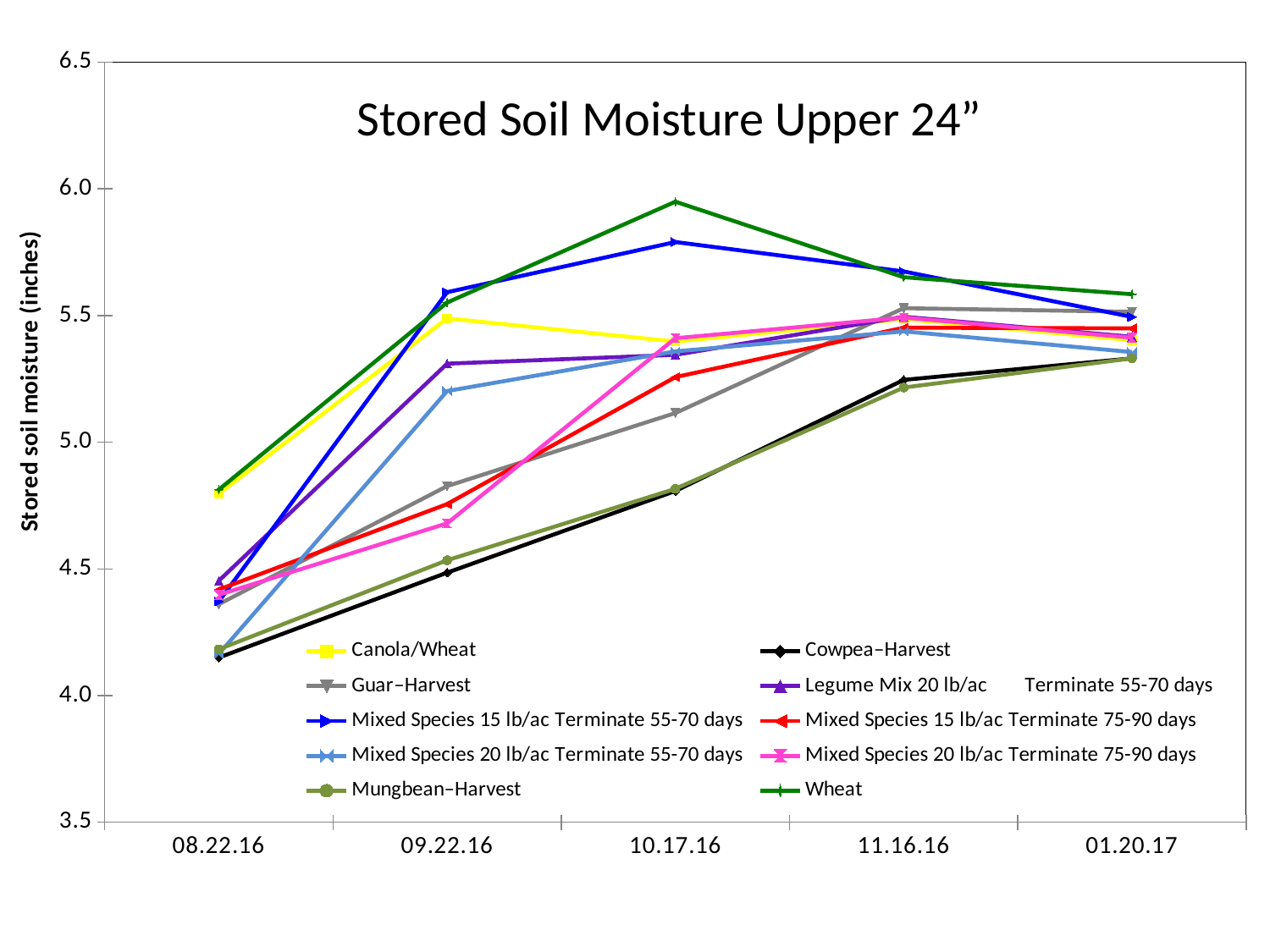
Is the value for Cowpea–Harvest on 08.22.16 greater or less than 4.5? less Is the value for Guar–Harvest on 10.17.16 greater or less than 5.0? greater Is the value for Mixed Species 15 lb/ac Terminate 55-70 days on 10.17.16 greater or less than 5.5? greater On 09.22.16, which is larger: Canola/Wheat or Mungbean–Harvest? Canola/Wheat How many series does the legend list? 10 What kind of chart is shown on the slide? line chart What is the title of the chart? Stored Soil Moisture Upper 24” How many dates are shown along the x axis? 5 Which series has the highest stored soil moisture on 10.17.16? Wheat On 10.17.16, which is larger: Wheat or Cowpea–Harvest? Wheat Does the Cowpea–Harvest series rise or fall from 08.22.16 to 01.20.17? rise